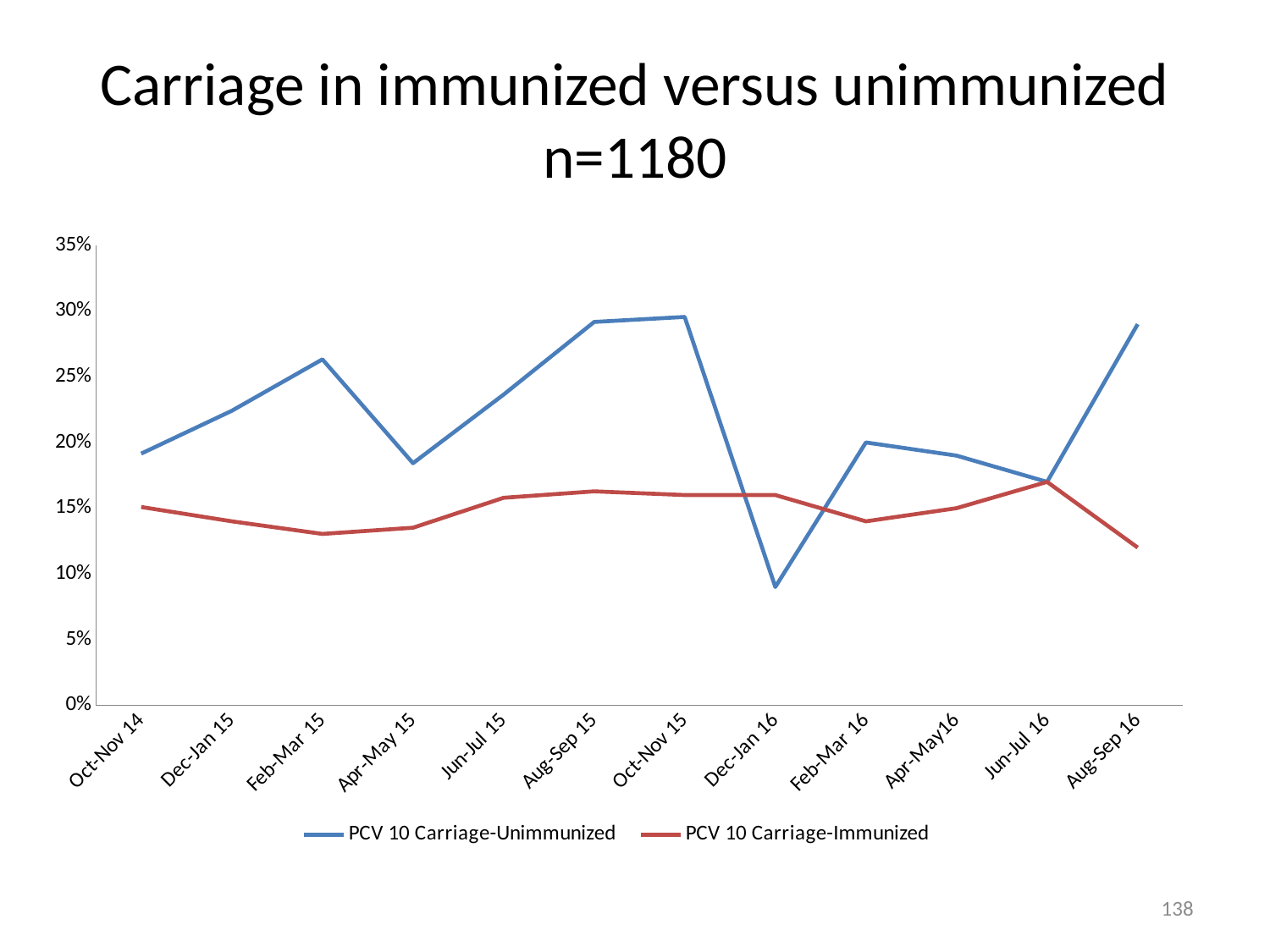
In which period is the PCV 10 Carriage-Unimmunized value lowest? Dec-Jan 16 Does the PCV 10 Carriage-Immunized line rise or fall from Jun-Jul 16 to Aug-Sep 16? Fall How many series does the legend list? 2 How many time periods are plotted along the x axis? 12 For Feb-Mar 15, which series has the larger value, PCV 10 Carriage-Unimmunized or PCV 10 Carriage-Immunized? PCV 10 Carriage-Unimmunized For Dec-Jan 16, which series has the larger value, PCV 10 Carriage-Unimmunized or PCV 10 Carriage-Immunized? PCV 10 Carriage-Immunized Is the PCV 10 Carriage-Unimmunized value for Aug-Sep 15 greater or less than 25%? greater Is the PCV 10 Carriage-Immunized value for Aug-Sep 16 greater or less than 15%? less What kind of chart is shown on the slide? Line chart Is the PCV 10 Carriage-Unimmunized value for Dec-Jan 16 greater or less than 10%? less What colour is the PCV 10 Carriage-Unimmunized line? Blue